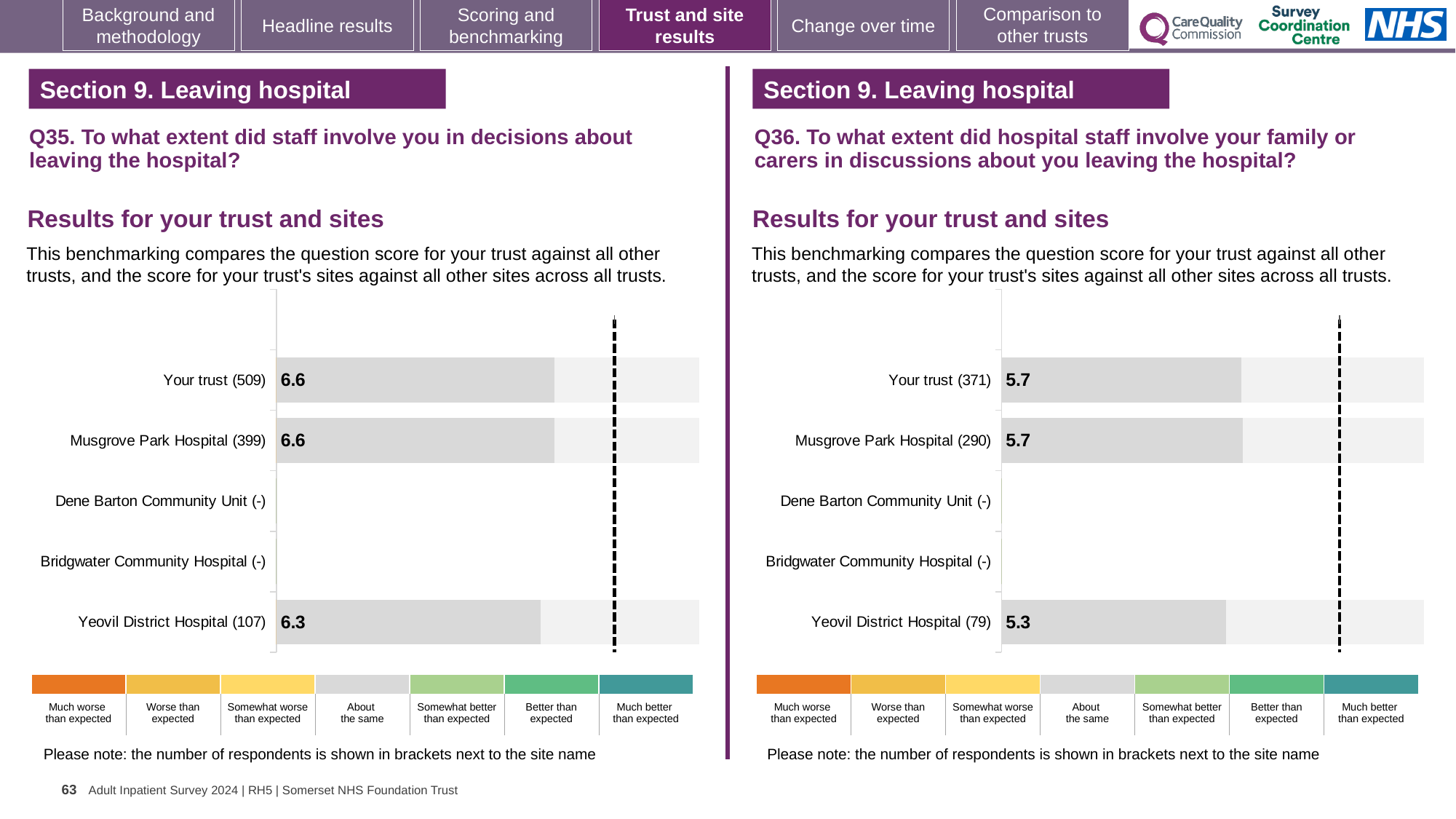
In the Q36 chart on the right, how many respondents are shown in brackets for Your trust? 371 In the Q36 chart on the right, what is the difference between the Your trust score and the Yeovil District Hospital score? 0.4 In the Q36 chart on the right, what is the score for Musgrove Park Hospital? 5.7 How many sites or rows are listed in the Q35 chart on the left? 5 In the Q35 chart on the left, what is the difference between the Musgrove Park Hospital score and the Yeovil District Hospital score? 0.3 In the Q36 chart on the right, what is the score for Yeovil District Hospital? 5.3 In the Q35 chart on the left, what is the score for Your trust? 6.6 In the Q36 chart on the right, which is larger, the score for Musgrove Park Hospital or the score for Yeovil District Hospital? Musgrove Park Hospital What kind of chart is used in the Q36 chart on the right? Bar chart In the Q35 chart on the left, how many respondents are shown in brackets for Musgrove Park Hospital? 399 In the Q35 chart on the left, what is the score for Yeovil District Hospital? 6.3 In the Q35 chart on the left, which site has the lowest score among those with a value shown? Yeovil District Hospital